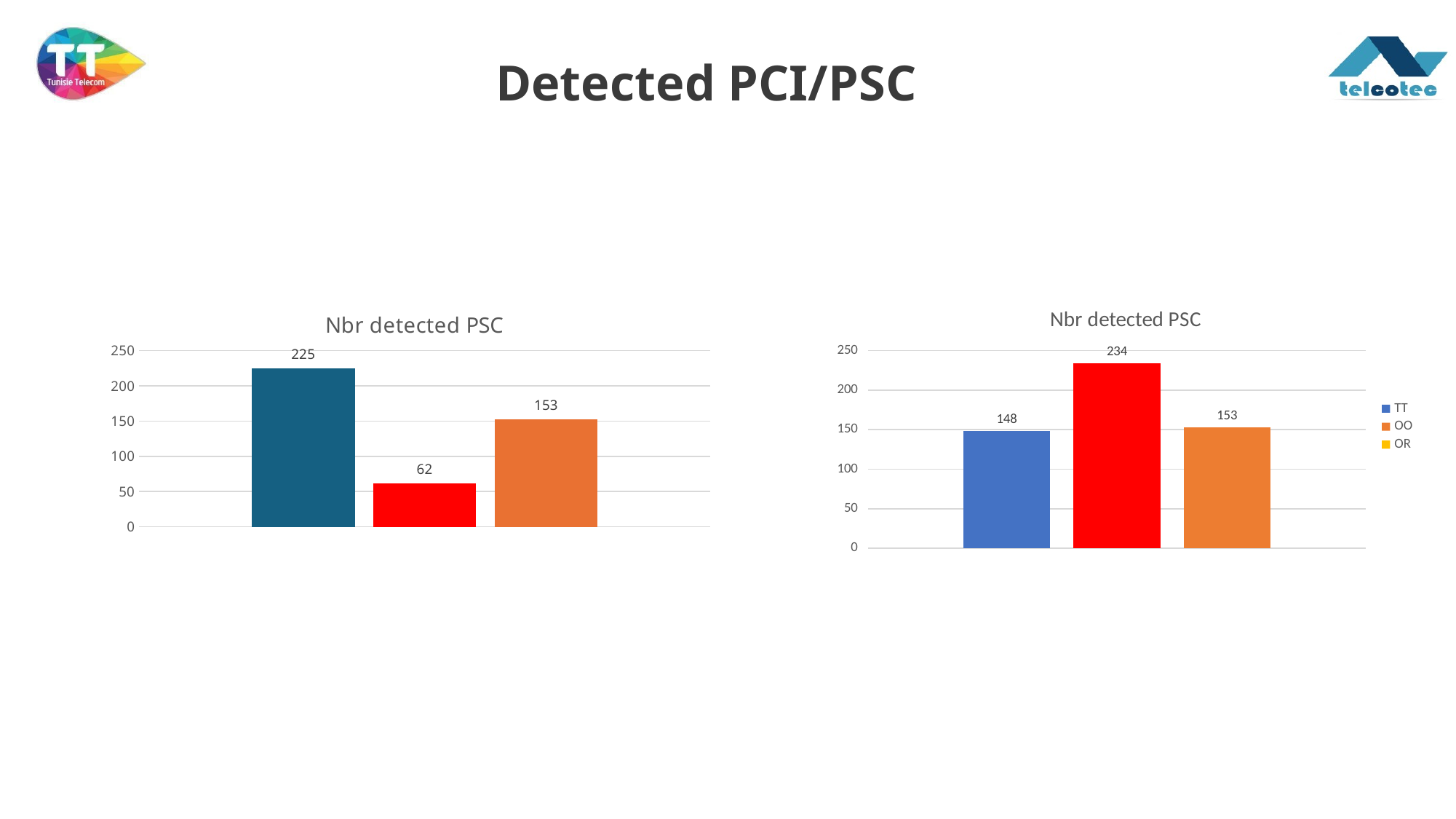
How many bars are plotted on the left chart? 3 On the left chart, what is the value of the orange bar? 153 On the right chart, what is the value of the blue bar? 148 What type of chart is used on the right side of the slide? Bar chart On the right chart, what is the value of the red bar? 234 On the left chart, what is the difference between the highest bar (225) and the lowest bar (62)? 163 On the left chart, what is the value of the red bar? 62 On the left chart, what is the value of the first (dark blue) bar? 225 On the right chart, which bar has the highest value? The red bar (234) On the right chart, what is the difference between the red bar (234) and the blue bar (148)? 86 How many entries does the legend of the right chart list? 3 On the left chart, which bar has the lowest value? The red bar (62)